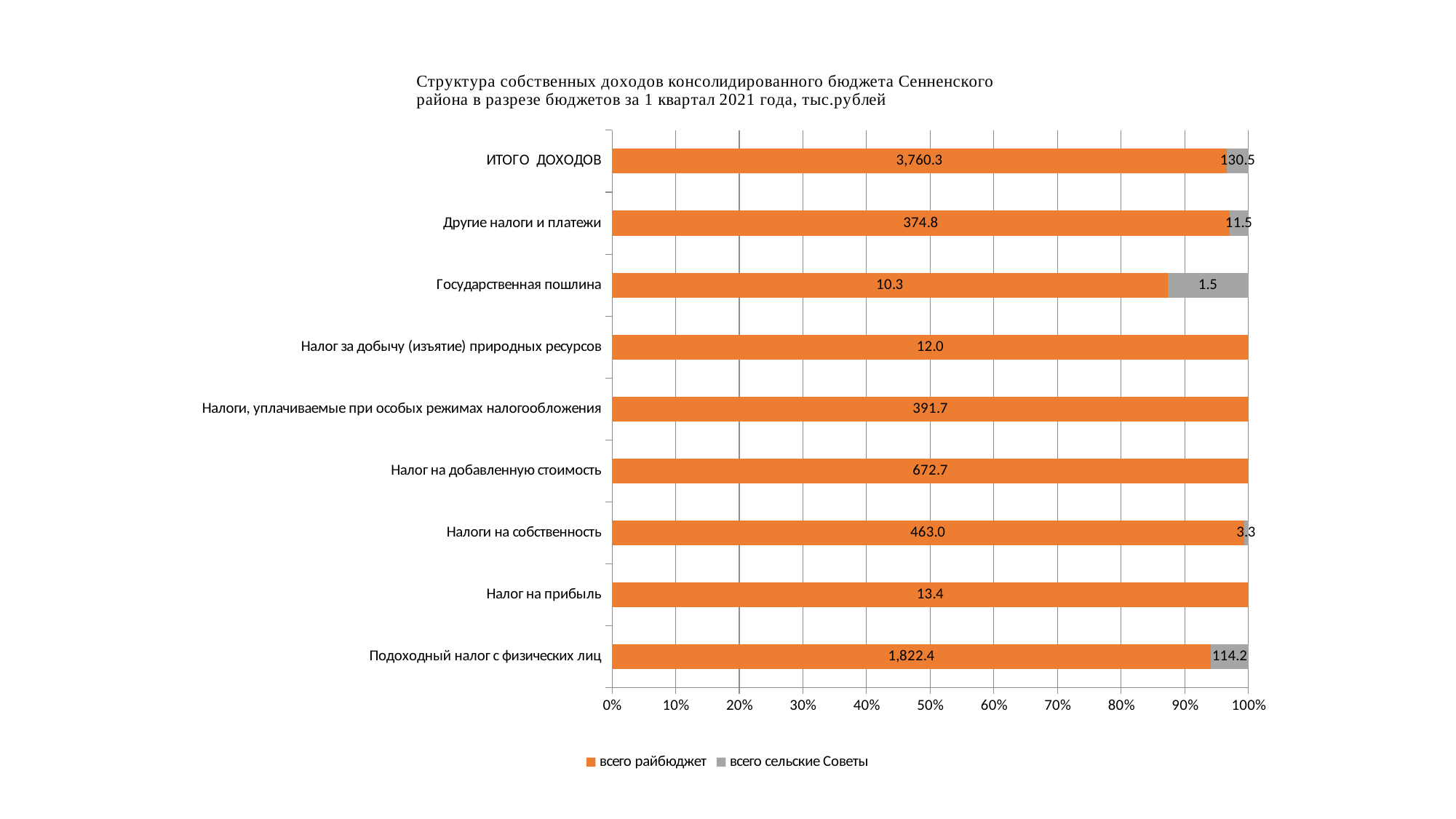
Which is larger: the всего райбюджет value for Налоги на собственность or for Другие налоги и платежи? Налоги на собственность How many series does the legend list? 2 What is the value of всего сельские Советы for Подоходный налог с физических лиц? 114.2 What is the difference between the всего райбюджет values for Налог на добавленную стоимость and Налоги, уплачиваемые при особых режимах налогообложения? 281.0 What is the combined total of всего райбюджет and всего сельские Советы for Государственная пошлина? 11.8 What is the value of всего сельские Советы for Государственная пошлина? 1.5 Excluding ИТОГО ДОХОДОВ, which category has the highest всего сельские Советы value? Подоходный налог с физических лиц Is the всего райбюджет share of the bar for Государственная пошлина greater or less than 90%? less Which category has the lowest всего райбюджет value? Государственная пошлина What is the value of всего райбюджет for Налог на добавленную стоимость? 672.7 What is the value of всего райбюджет for ИТОГО ДОХОДОВ? 3,760.3 How many categories are shown on the vertical axis? 9